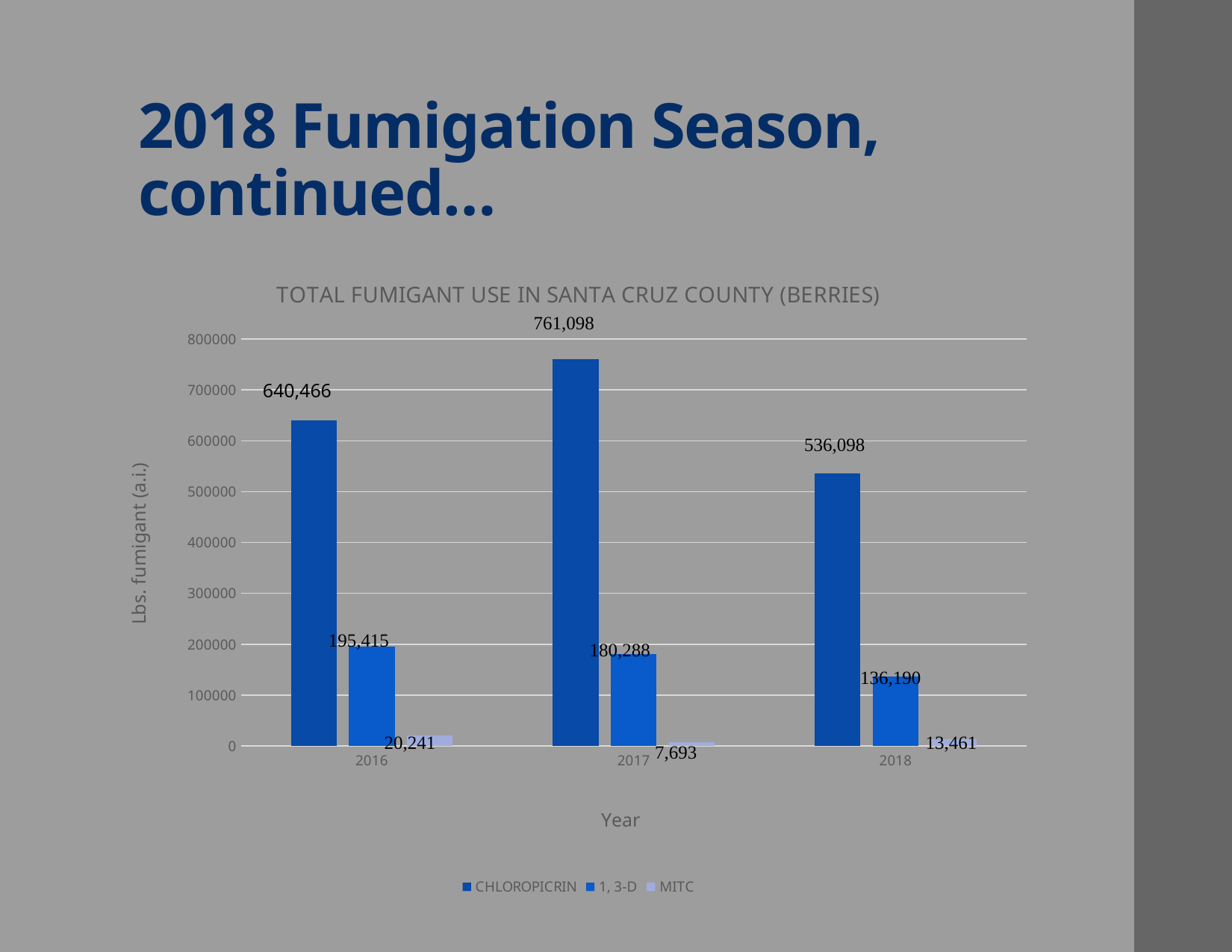
What is the difference between Chloropicrin use in 2017 and 2018? 225,000 In which year was MITC use lowest? 2017 What kind of chart is shown? bar chart How many series does the legend list? 3 How many years are shown on the x axis? 3 What was the 1, 3-D use in 2018? 136,190 What was the Chloropicrin use in 2017? 761,098 What is the title of the chart? TOTAL FUMIGANT USE IN SANTA CRUZ COUNTY (BERRIES) Which was larger in 2016: 1, 3-D use or MITC use? 1, 3-D In which year was Chloropicrin use highest? 2017 Is the Chloropicrin value for 2018 greater or less than 600000? less What was the MITC use in 2016? 20,241